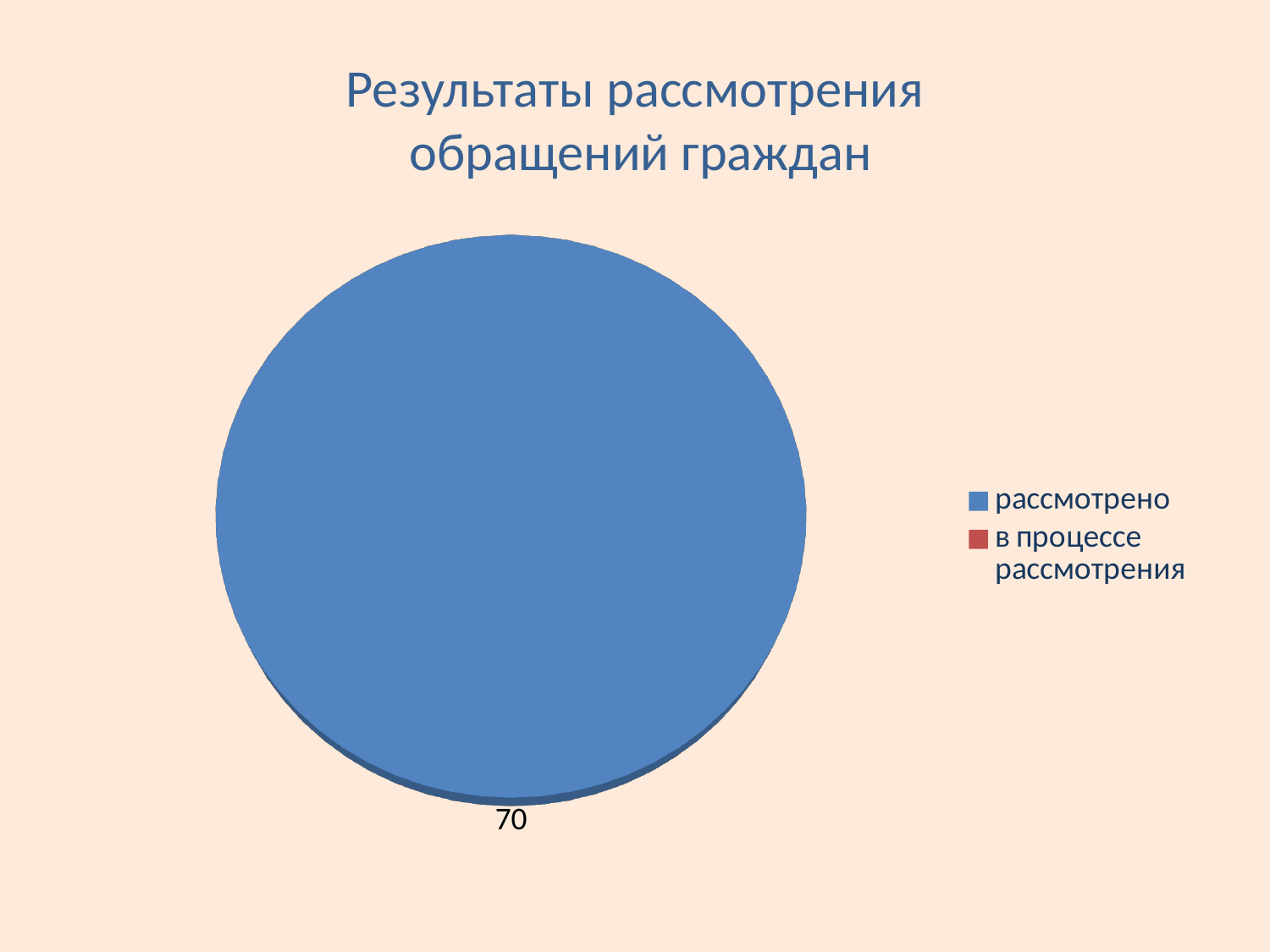
Which category has the largest slice of the pie? рассмотрено What is the title of the chart? Результаты рассмотрения обращений граждан What is the value shown for the "рассмотрено" slice? 70 Is the value for "рассмотрено" greater or less than 50? greater What kind of chart is shown on the slide? pie chart What colour represents "рассмотрено" in the legend? blue How many entries does the legend list? 2 Which is larger, "рассмотрено" or "в процессе рассмотрения"? рассмотрено